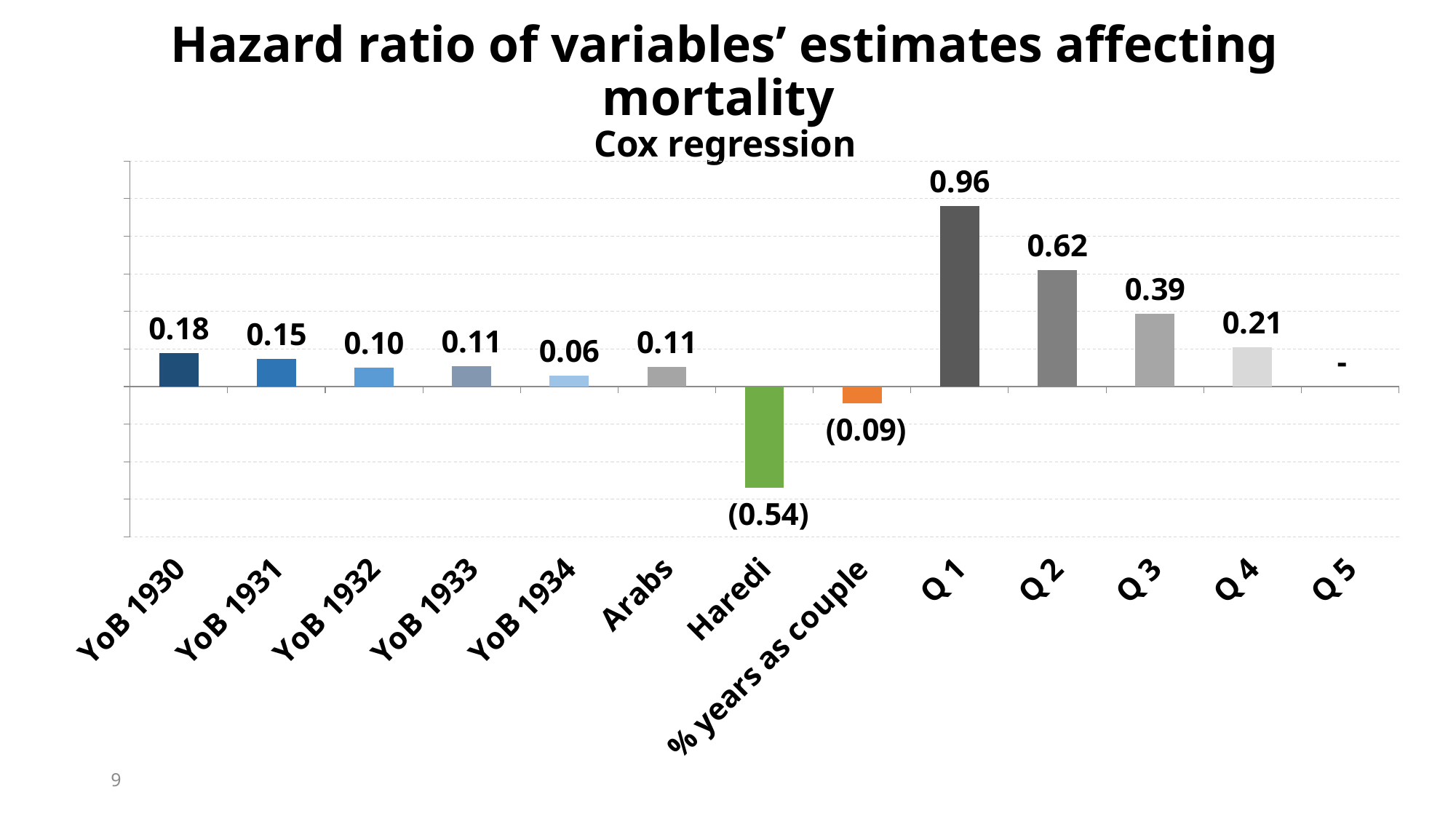
How many categories are shown on the x axis? 13 Which category has the lowest (most negative) value? Haredi What is the value shown for Arabs? 0.11 What is the difference between the values for Q 3 and Q 4? 0.18 What kind of chart is shown on the slide? Bar chart Which is larger, the value for YoB 1930 or the value for YoB 1932? YoB 1930 What is the value shown for Q 1? 0.96 What is the value shown for Haredi? (0.54) What is the value shown for YoB 1934? 0.06 What is the difference between the values for Q 1 and Q 2? 0.34 What is the value shown for % years as couple? (0.09) Which category has the highest value? Q 1